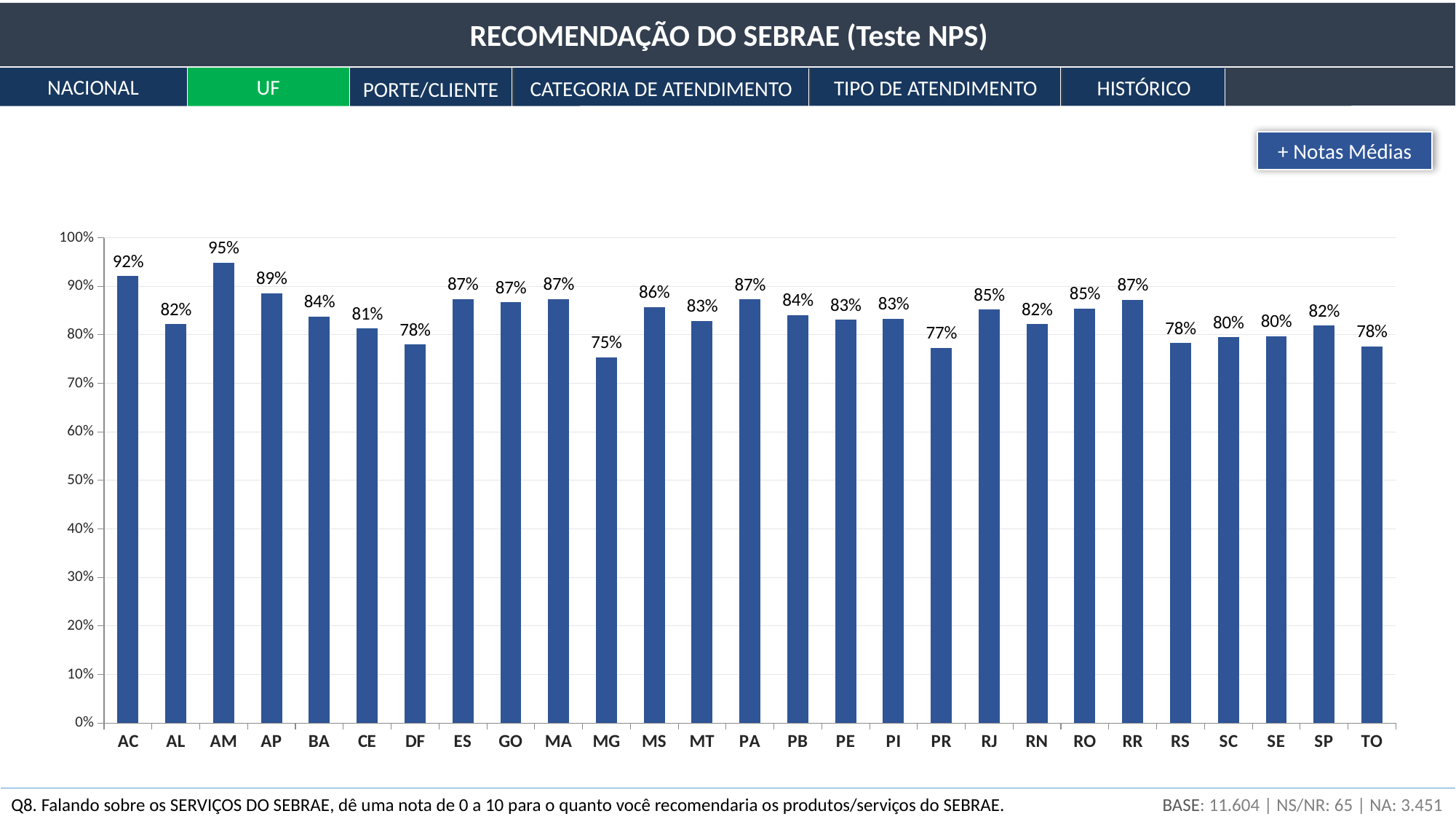
Which has a larger value, AP or BA? AP What is the value for PR? 77% What is the value for SP? 82% How many UFs are shown on the x axis? 27 What is the value for MG? 75% Which UF has the highest value? AM What is the title of the slide? RECOMENDAÇÃO DO SEBRAE (Teste NPS) What is the value for AM? 95% What is the difference between the values for AM and MG? 20% Which UF has the lowest value? MG What is the difference between the values for AC and AL? 10% What kind of chart is shown on the slide? Bar chart